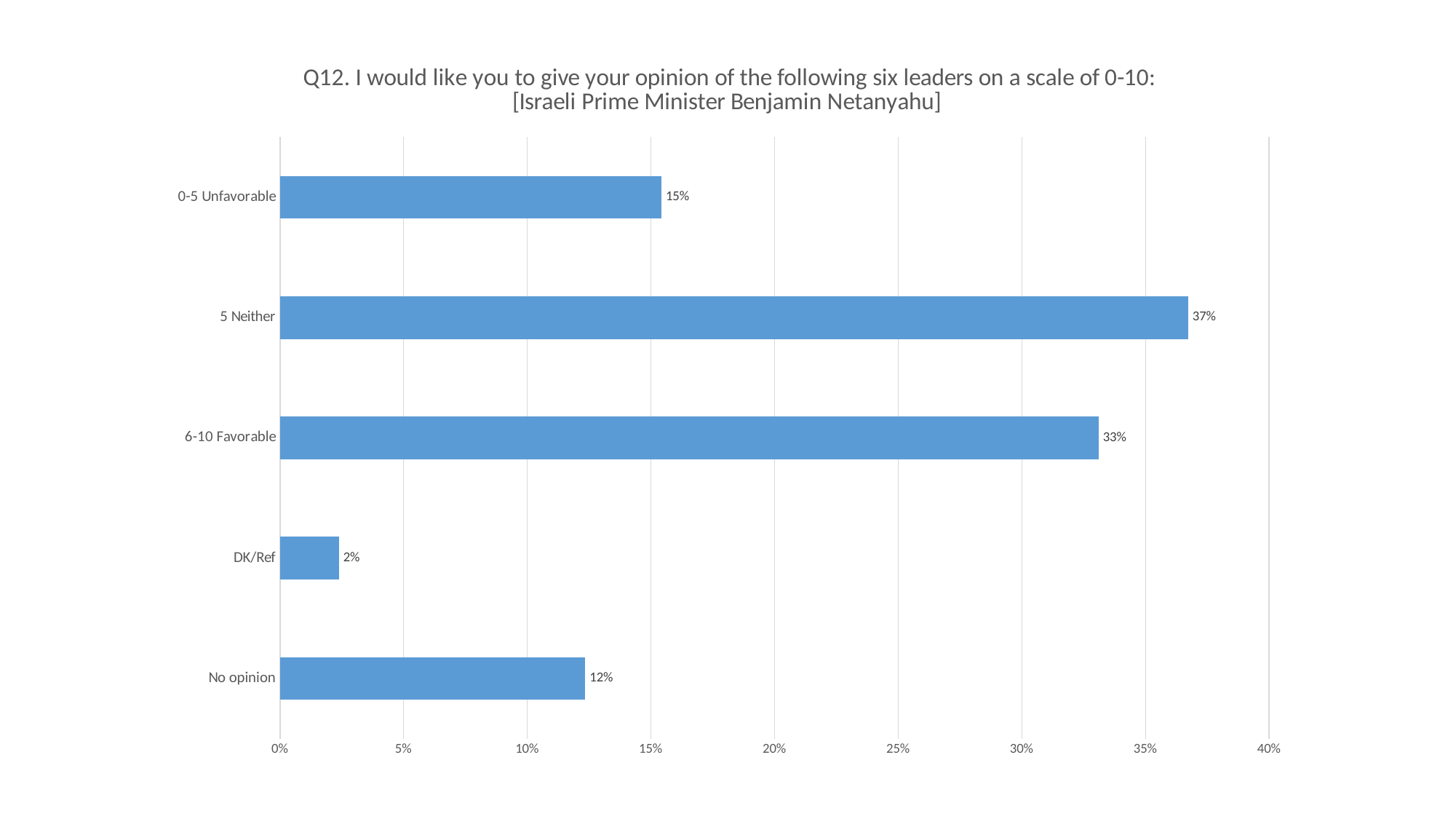
Which category has the lowest value? DK/Ref What is the value shown for '6-10 Favorable'? 33% Which is larger, '0-5 Unfavorable' or 'No opinion'? 0-5 Unfavorable What is the value for 'DK/Ref'? 2% What is the difference between the '5 Neither' and '6-10 Favorable' values? 4% Which leader is this chart about? Israeli Prime Minister Benjamin Netanyahu What percentage is shown for 'No opinion'? 12% What percentage of respondents gave a '5 Neither' rating for Israeli Prime Minister Benjamin Netanyahu? 37% What is the difference between '0-5 Unfavorable' and 'No opinion'? 3% What type of chart is shown on the slide? Bar chart Which category has the highest value? 5 Neither How many categories are shown in the chart? 5